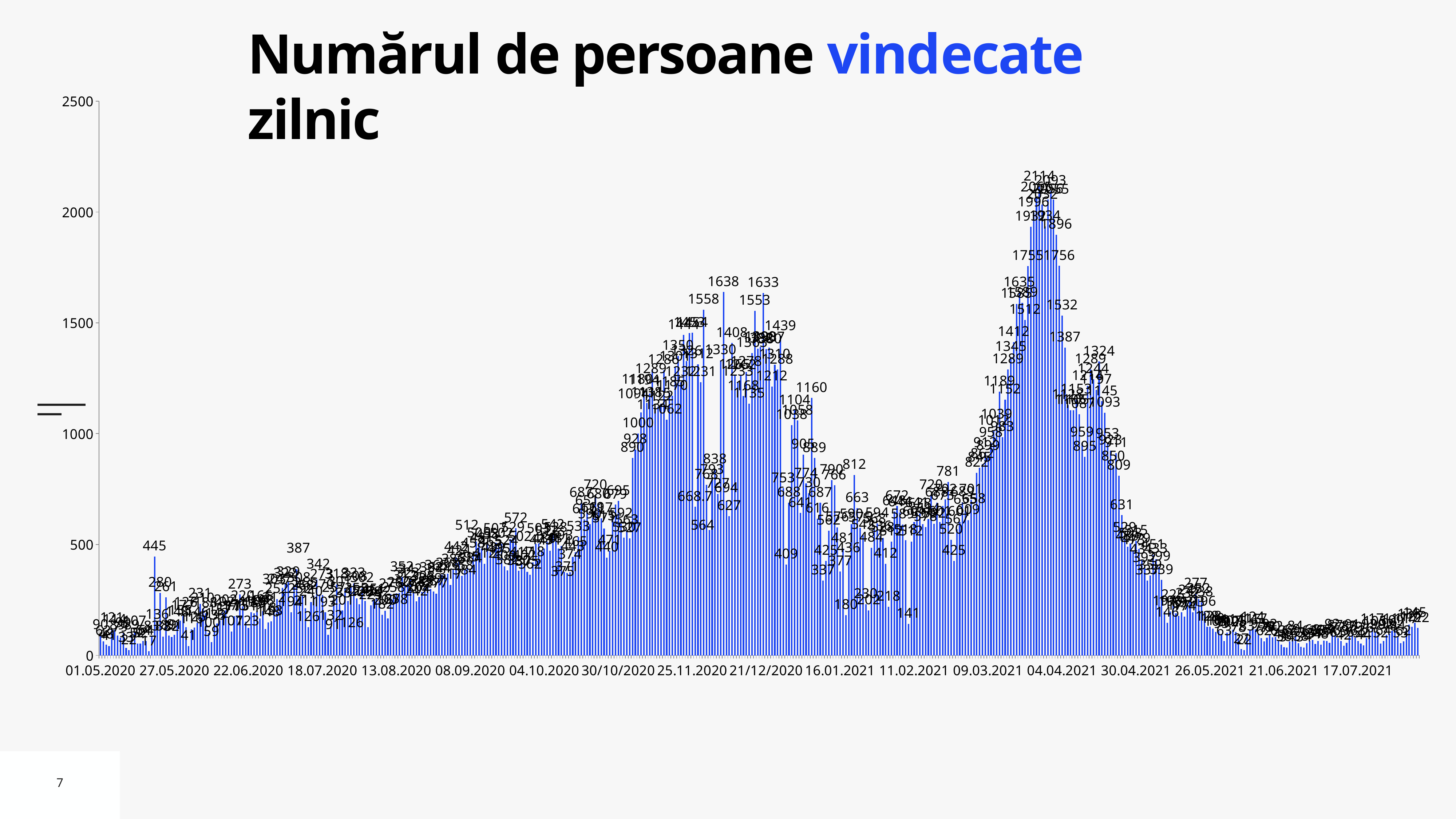
What is the first date label on the horizontal axis? 01.05.2020 What is the highest daily value labelled on the chart? 2114 What is the last date label on the horizontal axis? 17.07.2021 Is the value for 01.05.2020 greater or less than 500? less Do the values rise or fall between 04.04.2021 and 26.05.2021? fall What is the difference between the peak value 2114 (around 04.04.2021) and the peak value 1638 (around 25.11.2020)? 476 Is the value for 04.04.2021 greater or less than 1500? greater Do the values rise or fall between 09.03.2021 and 04.04.2021? rise Which peak is higher: the one around 25.11.2020 (labelled 1638) or the one around 04.04.2021 (labelled 2114)? the one around 04.04.2021 (2114) What is the title of the chart? Numărul de persoane vindecate zilnic What is the highest value shown on the vertical axis? 2500 What kind of chart is shown on the slide? bar chart